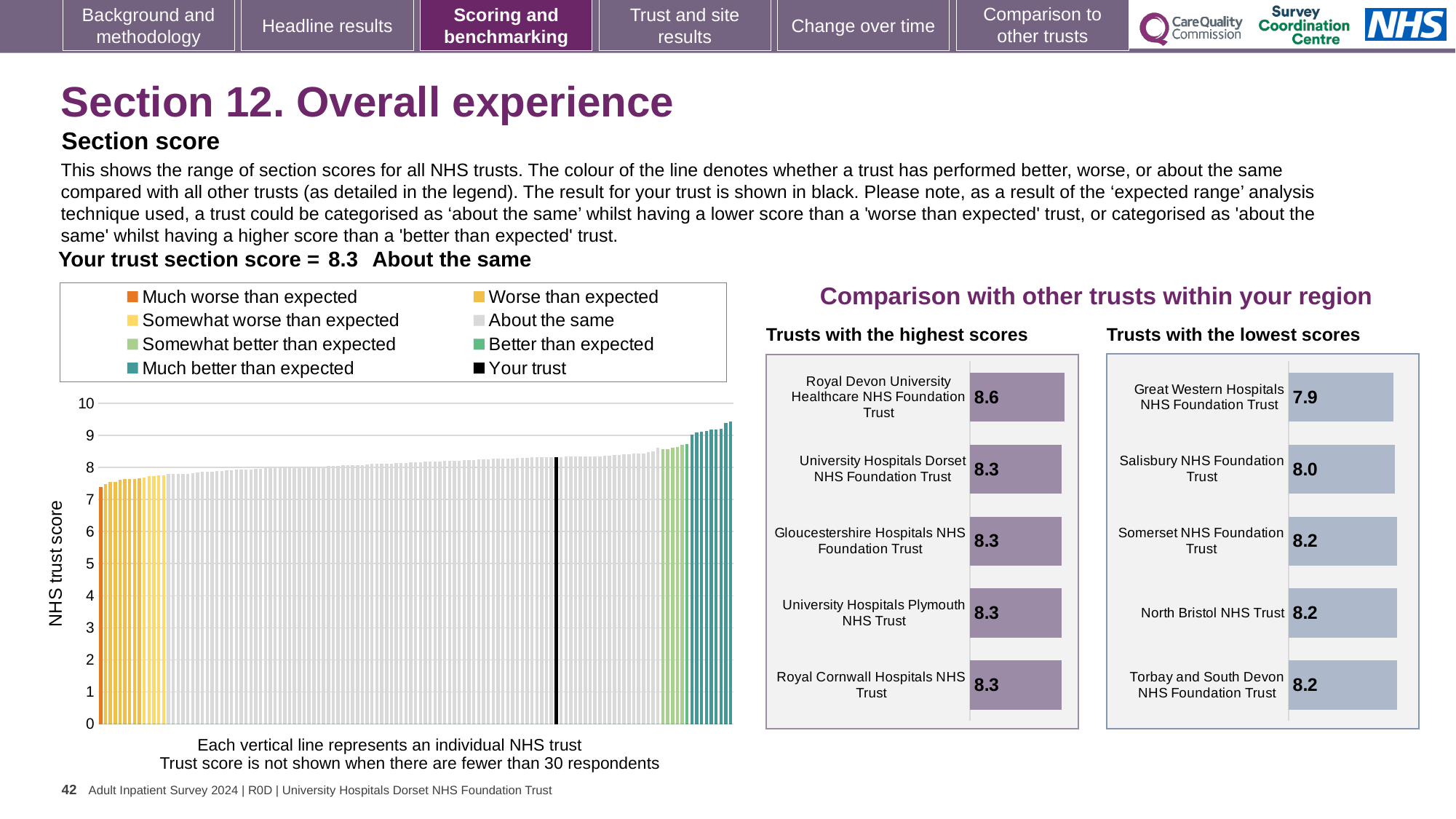
In the 'Trusts with the lowest scores' chart, what is the difference between the scores of Salisbury NHS Foundation Trust and Great Western Hospitals NHS Foundation Trust? 0.1 How many entries does the legend of the large chart on the left list? 8 What kind of chart is the large chart on the left showing NHS trust scores? Bar chart How many trusts are shown in the 'Trusts with the highest scores' chart? 5 In the 'Trusts with the highest scores' chart, what is the difference between the scores of Royal Devon University Healthcare NHS Foundation Trust and University Hospitals Dorset NHS Foundation Trust? 0.3 In the 'Trusts with the lowest scores' chart, what is the score for Great Western Hospitals NHS Foundation Trust? 7.9 In the 'Trusts with the lowest scores' chart, which has the larger score: Somerset NHS Foundation Trust or Great Western Hospitals NHS Foundation Trust? Somerset NHS Foundation Trust In the 'Trusts with the lowest scores' chart, which trust has the lowest score? Great Western Hospitals NHS Foundation Trust In the 'Trusts with the highest scores' chart, which trust has the highest score? Royal Devon University Healthcare NHS Foundation Trust In the 'Trusts with the lowest scores' chart, what is the score for Salisbury NHS Foundation Trust? 8.0 In the 'Trusts with the highest scores' chart, what is the score for Royal Devon University Healthcare NHS Foundation Trust? 8.6 In the large chart on the left, do the NHS trust scores rise or fall from left to right along the x axis? Rise